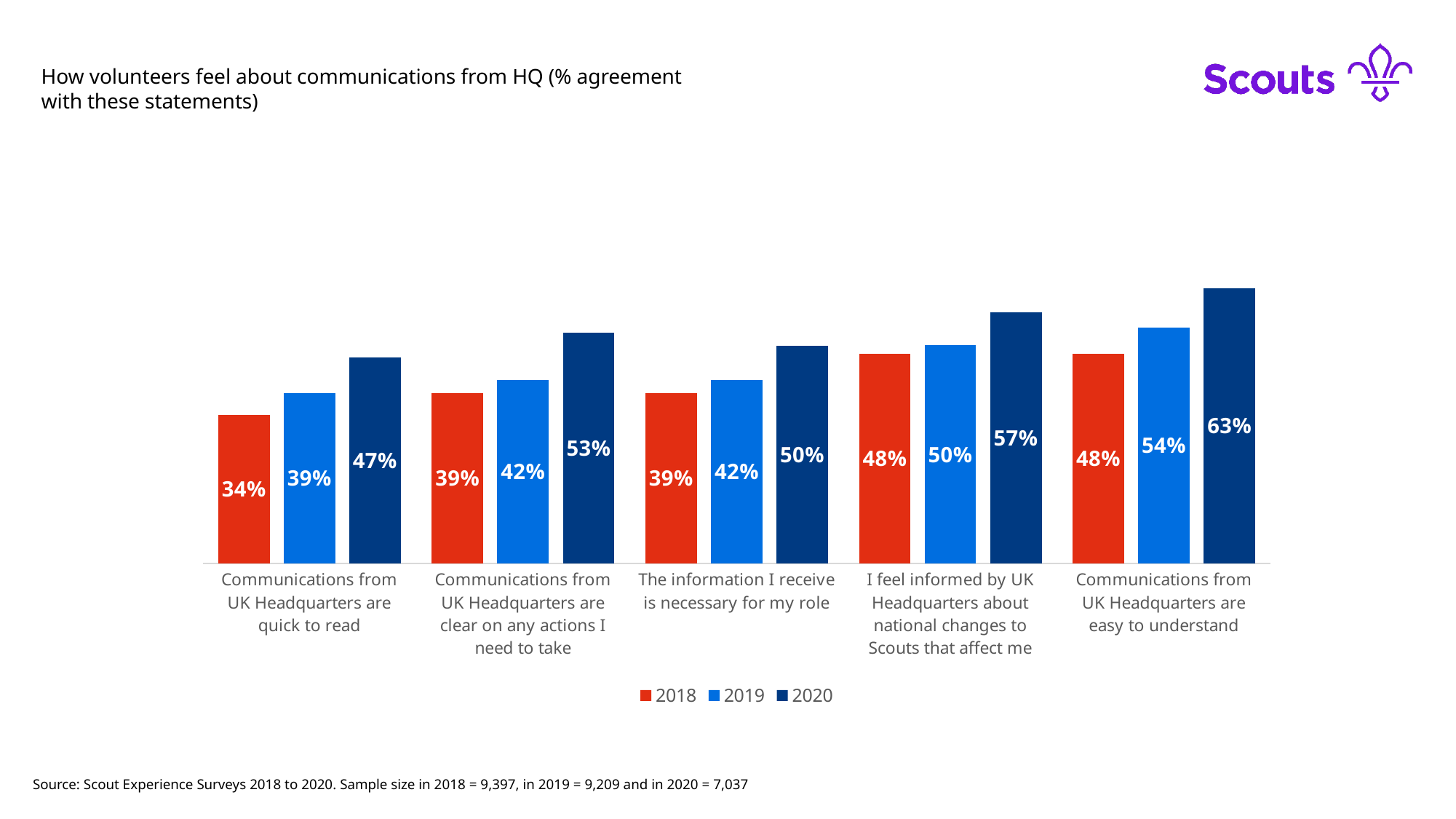
How many statements (categories) are shown on the x axis? 5 What is the 2020 value for 'Communications from UK Headquarters are easy to understand'? 63% What is the difference between the 2020 and 2018 values for 'Communications from UK Headquarters are quick to read'? 13% What is the 2019 value for 'I feel informed by UK Headquarters about national changes to Scouts that affect me'? 50% Which statement has the highest 2020 value? Communications from UK Headquarters are easy to understand What kind of chart is shown on the slide? Bar chart Which statement has the lowest 2018 value? Communications from UK Headquarters are quick to read Which is larger: the 2020 value for 'The information I receive is necessary for my role' or the 2020 value for 'Communications from UK Headquarters are clear on any actions I need to take'? Communications from UK Headquarters are clear on any actions I need to take For 'Communications from UK Headquarters are easy to understand', do the values rise or fall from 2018 to 2020? Rise How many series does the legend list? 3 Which colour represents the 2018 series in the legend? Red What is the 2018 value for 'Communications from UK Headquarters are quick to read'? 34%